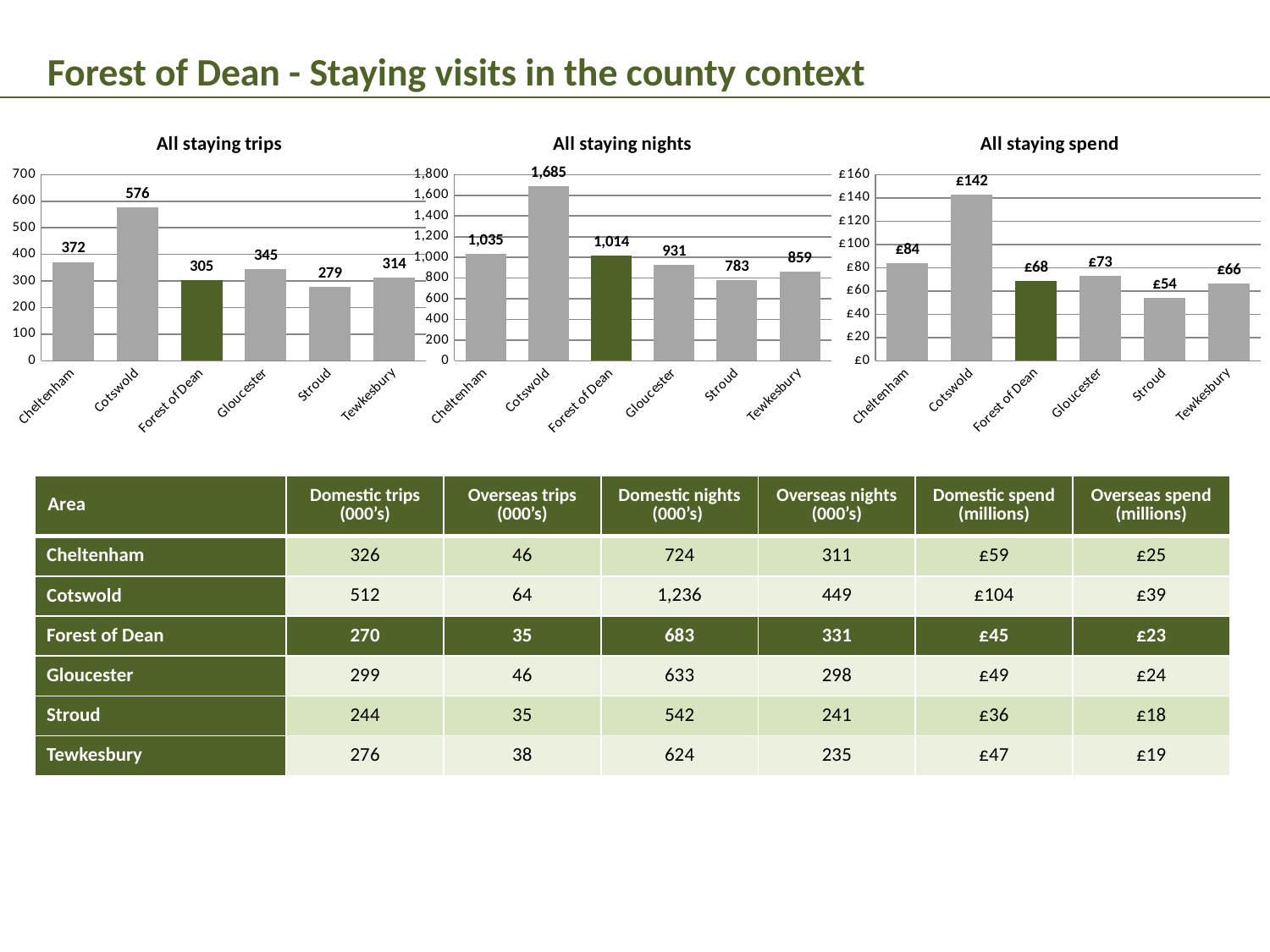
In the 'All staying nights' chart, what is the difference between Cheltenham and Forest of Dean? 21 In the 'All staying nights' chart, which is larger, Gloucester or Tewkesbury? Gloucester In the 'All staying trips' chart, what is the value for Forest of Dean? 305 In the 'All staying spend' chart, which bar is coloured dark green rather than grey? Forest of Dean In the 'All staying spend' chart, is the value for Forest of Dean greater or less than £80? less In the 'All staying spend' chart, what is the difference between Cotswold and Cheltenham? £58 What type of chart is the 'All staying nights' chart? bar chart In the 'All staying spend' chart, what is the value for Stroud? £54 In the 'All staying trips' chart, which area has the lowest value? Stroud In the 'All staying trips' chart, which area has the highest value? Cotswold In the 'All staying nights' chart, what is the value for Cotswold? 1,685 How many areas are shown in the 'All staying trips' chart? 6